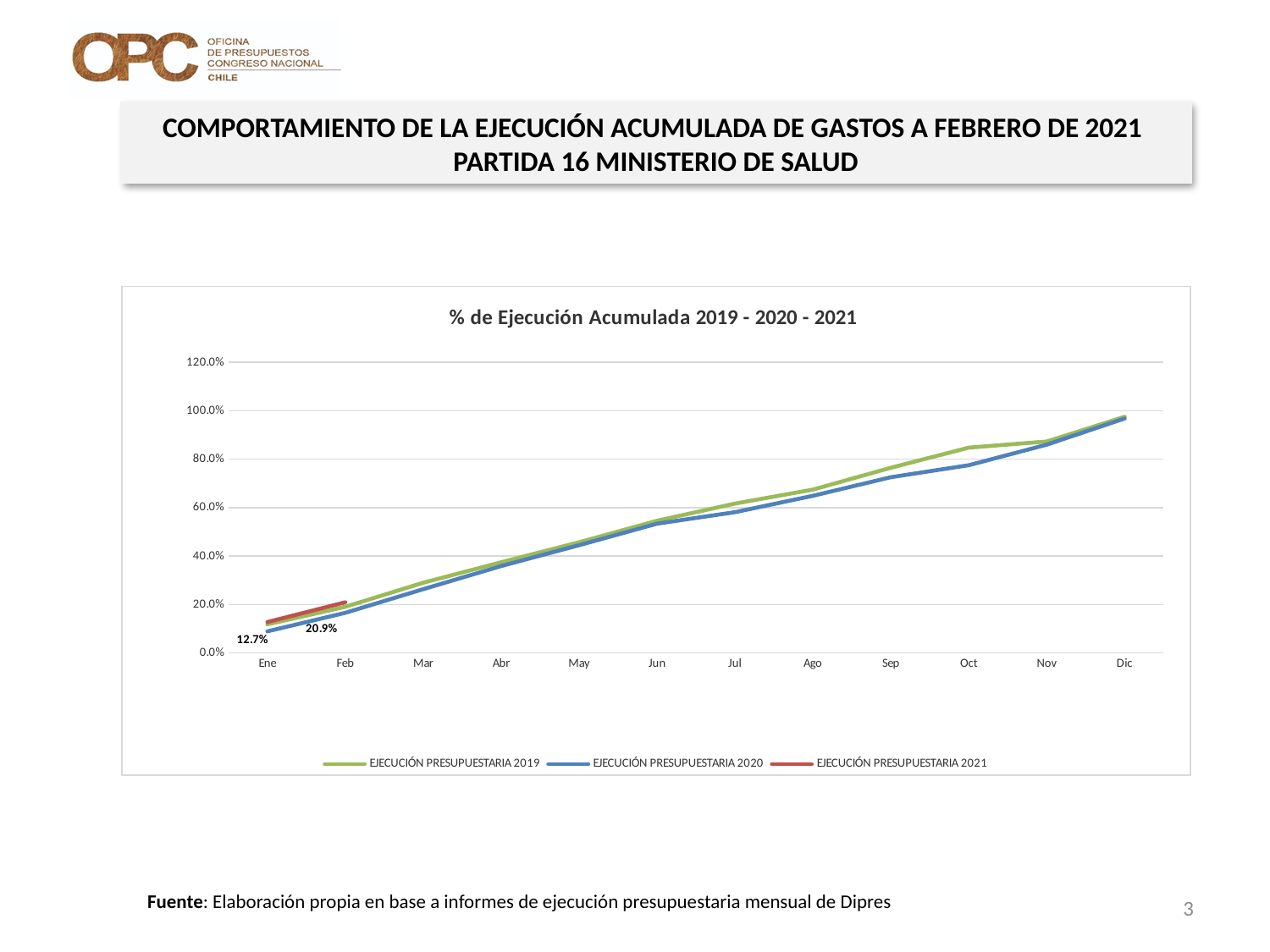
Is the value for EJECUCIÓN PRESUPUESTARIA 2019 in Oct greater or less than 80.0%? greater What is the value of EJECUCIÓN PRESUPUESTARIA 2021 in Ene? 12.7% What kind of chart is shown on the slide? line chart Is the value for EJECUCIÓN PRESUPUESTARIA 2020 in Sep greater or less than 80.0%? less What is the title of the chart? % de Ejecución Acumulada 2019 - 2020 - 2021 How many months are shown along the x axis of the chart? 12 In which month does EJECUCIÓN PRESUPUESTARIA 2020 reach its highest value? Dic By how many percentage points did EJECUCIÓN PRESUPUESTARIA 2021 increase from Ene to Feb? 8.2 percentage points What is the value of EJECUCIÓN PRESUPUESTARIA 2021 in Feb? 20.9% How many series does the chart legend list? 3 Do the values of EJECUCIÓN PRESUPUESTARIA 2019 rise or fall from Ene to Dic? rise In Oct, which series has the higher value: EJECUCIÓN PRESUPUESTARIA 2019 or EJECUCIÓN PRESUPUESTARIA 2020? EJECUCIÓN PRESUPUESTARIA 2019